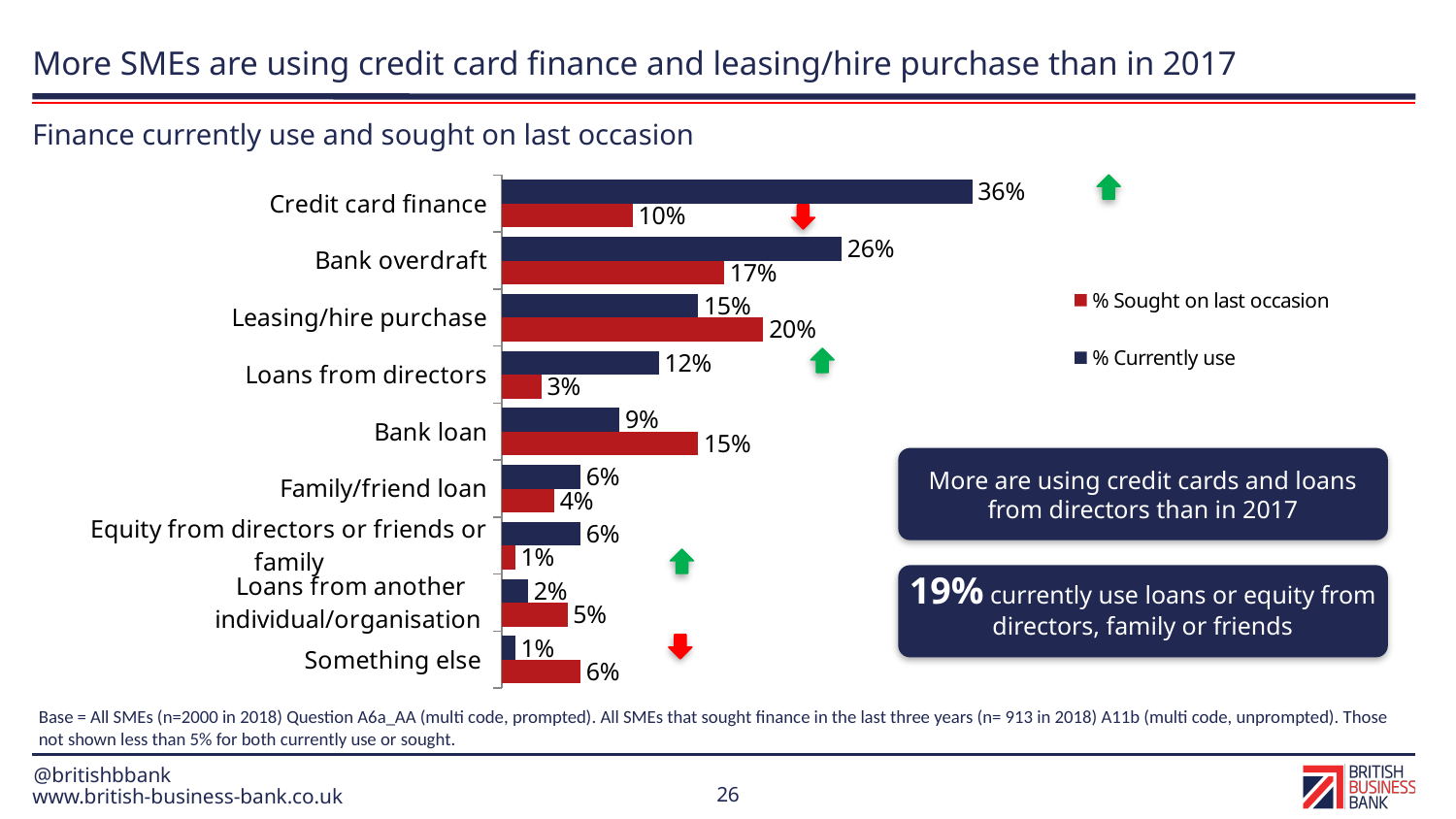
What colour represents the '% Currently use' series? Navy blue What is the '% Sought on last occasion' value for Something else? 6% What is the '% Currently use' value for Loans from directors? 12% How many finance categories are shown on the chart? 9 What percentage of SMEs currently use credit card finance? 36% What is the difference between '% Currently use' and '% Sought on last occasion' for Bank overdraft? 9% What kind of chart is shown on the slide? Bar chart What is the value for '% Sought on last occasion' for Leasing/hire purchase? 20% Which category has the highest '% Currently use' value? Credit card finance Which category has the lowest '% Sought on last occasion' value? Equity from directors or friends or family How many series does the legend list? 2 For Bank loan, which is larger: '% Currently use' or '% Sought on last occasion'? % Sought on last occasion